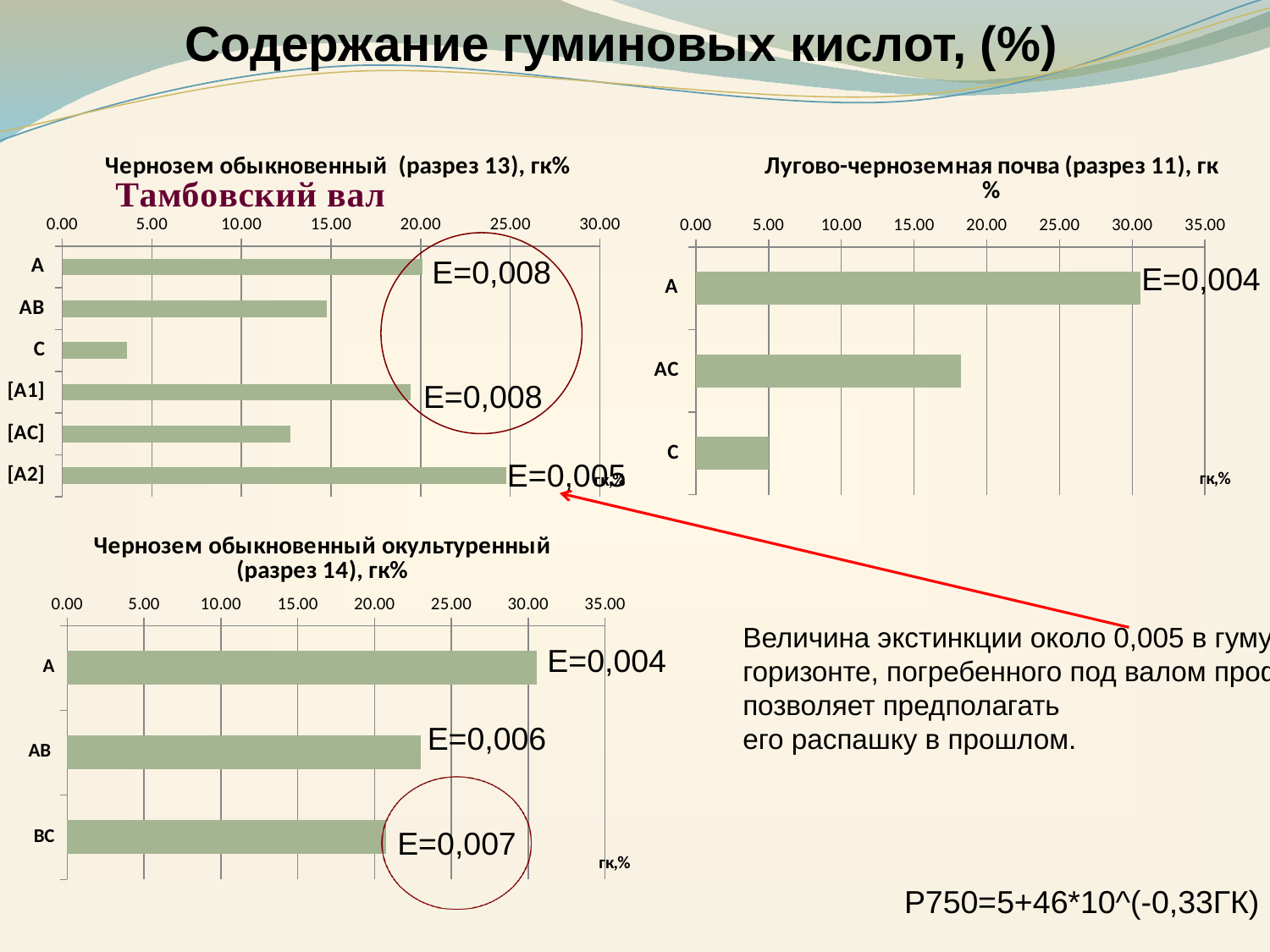
In the chart titled "Лугово-черноземная почва (разрез 11), гк%", which category has the highest value? A In the chart titled "Чернозем обыкновенный (разрез 13), гк%", is the value for C greater or less than 5.00? less In the chart titled "Чернозем обыкновенный (разрез 13), гк%", which category has the lowest value? C In the chart titled "Чернозем обыкновенный (разрез 13), гк%", which category has the highest value? [A2] In the chart titled "Чернозем обыкновенный окультуренный (разрез 14), гк%", is the value for A greater or less than 25.00? greater In the chart titled "Лугово-черноземная почва (разрез 11), гк%", is the value for AC greater or less than 20.00? less In the chart titled "Чернозем обыкновенный окультуренный (разрез 14), гк%", which category has the lowest value? BC In the chart titled "Чернозем обыкновенный окультуренный (разрез 14), гк%", what E value is annotated next to the BC bar? E=0,007 What kind of chart is the chart titled "Чернозем обыкновенный окультуренный (разрез 14), гк%"? bar chart How many categories are shown in the chart titled "Чернозем обыкновенный (разрез 13), гк%"? 6 In the chart titled "Лугово-черноземная почва (разрез 11), гк%", which is larger, the value for AC or the value for C? AC